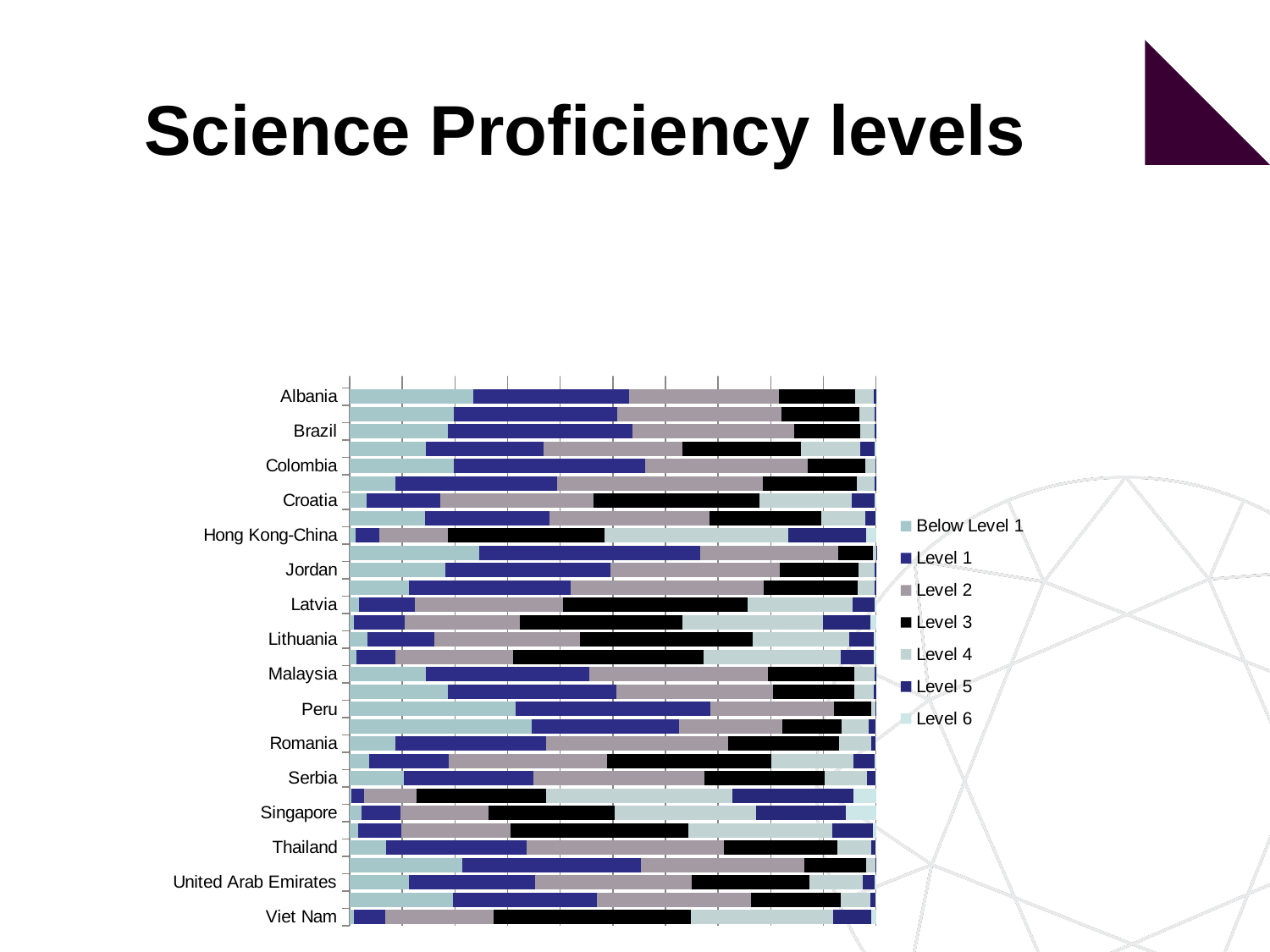
Which has a larger Level 5 segment, Singapore or Jordan? Singapore Among the labelled countries, which has the largest Below Level 1 segment? Peru Which has a larger Level 3 segment, Viet Nam or Peru? Viet Nam Which has a larger Level 2 segment, Croatia or Hong Kong-China? Croatia What kind of chart is shown on the slide? bar chart What is the first entry in the chart's legend? Below Level 1 What is the title of the slide? Science Proficiency levels How many series does the legend list? 7